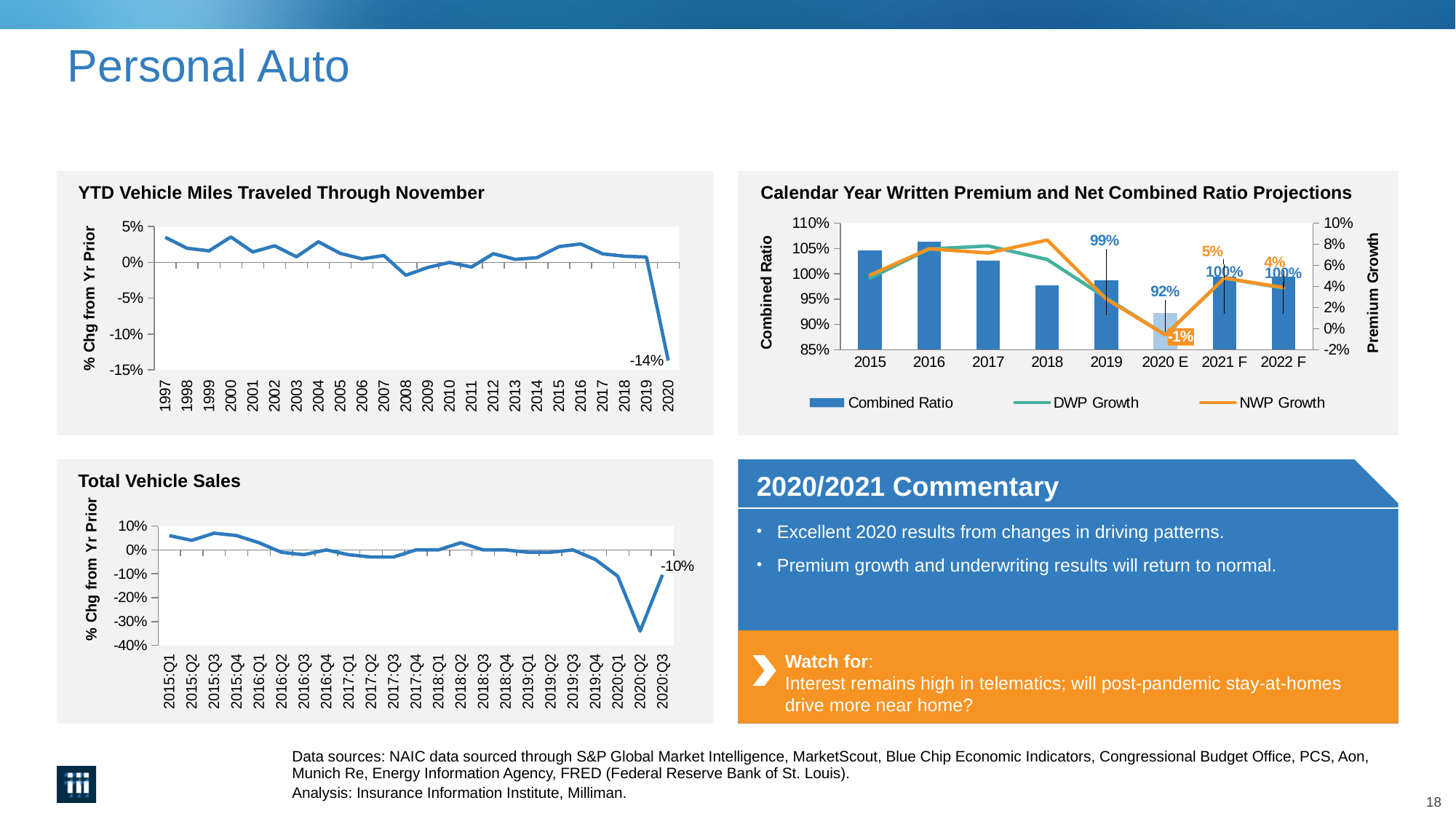
In the Calendar Year Written Premium and Net Combined Ratio Projections chart, what is the NWP Growth for 2020 E? -1% How many series does the legend of the Calendar Year Written Premium and Net Combined Ratio Projections chart list? 3 In the Calendar Year Written Premium and Net Combined Ratio Projections chart, what is the difference between the Combined Ratio for 2019 and for 2020 E? 7 percentage points In the Calendar Year Written Premium and Net Combined Ratio Projections chart, which year has the lowest Combined Ratio? 2020 E How many years are shown on the x axis of the Calendar Year Written Premium and Net Combined Ratio Projections chart? 8 In the YTD Vehicle Miles Traveled Through November chart, what is the value for 2020? -14% In the Total Vehicle Sales chart, is the value for 2020:Q2 greater or less than -30%? less In the Calendar Year Written Premium and Net Combined Ratio Projections chart, which year has the highest Combined Ratio? 2016 In the Calendar Year Written Premium and Net Combined Ratio Projections chart, what is the NWP Growth for 2021 F? 5% In the Calendar Year Written Premium and Net Combined Ratio Projections chart, what is the Combined Ratio for 2019? 99% What kind of chart is the YTD Vehicle Miles Traveled Through November chart? Line chart In the Total Vehicle Sales chart, what is the value for 2020:Q3? -10%